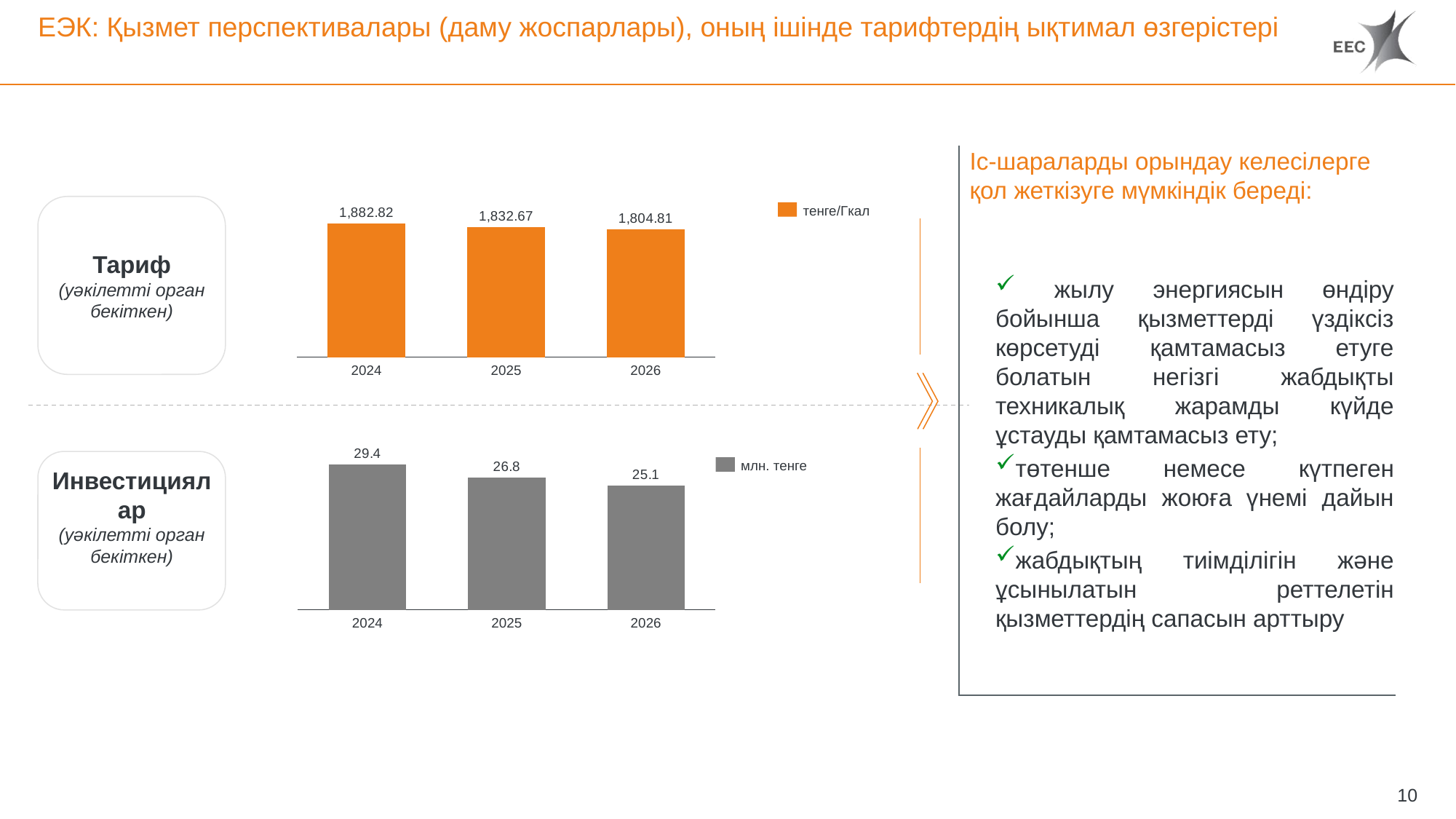
In the top chart (Тариф), what is the value for 2024? 1,882.82 In the bottom chart (Инвестициялар), which is larger, the value for 2024 or the value for 2025? 2024 How many years are shown on the x axis of the bottom chart (Инвестициялар)? 3 In the bottom chart (Инвестициялар), what is the difference between the 2024 and 2026 values? 4.3 In the top chart (Тариф), what is the difference between the 2024 and 2026 values? 78.01 In the bottom chart (Инвестициялар), which year has the lowest value? 2026 In the bottom chart (Инвестициялар), what is the value for 2025? 26.8 In the top chart (Тариф), what is the value for 2026? 1,804.81 What unit does the legend of the bottom chart (Инвестициялар) show? млн. тенге What type of chart is the top chart (Тариф)? bar chart In the top chart (Тариф), do the values rise or fall from 2024 to 2026? fall In the top chart (Тариф), which year has the highest value? 2024